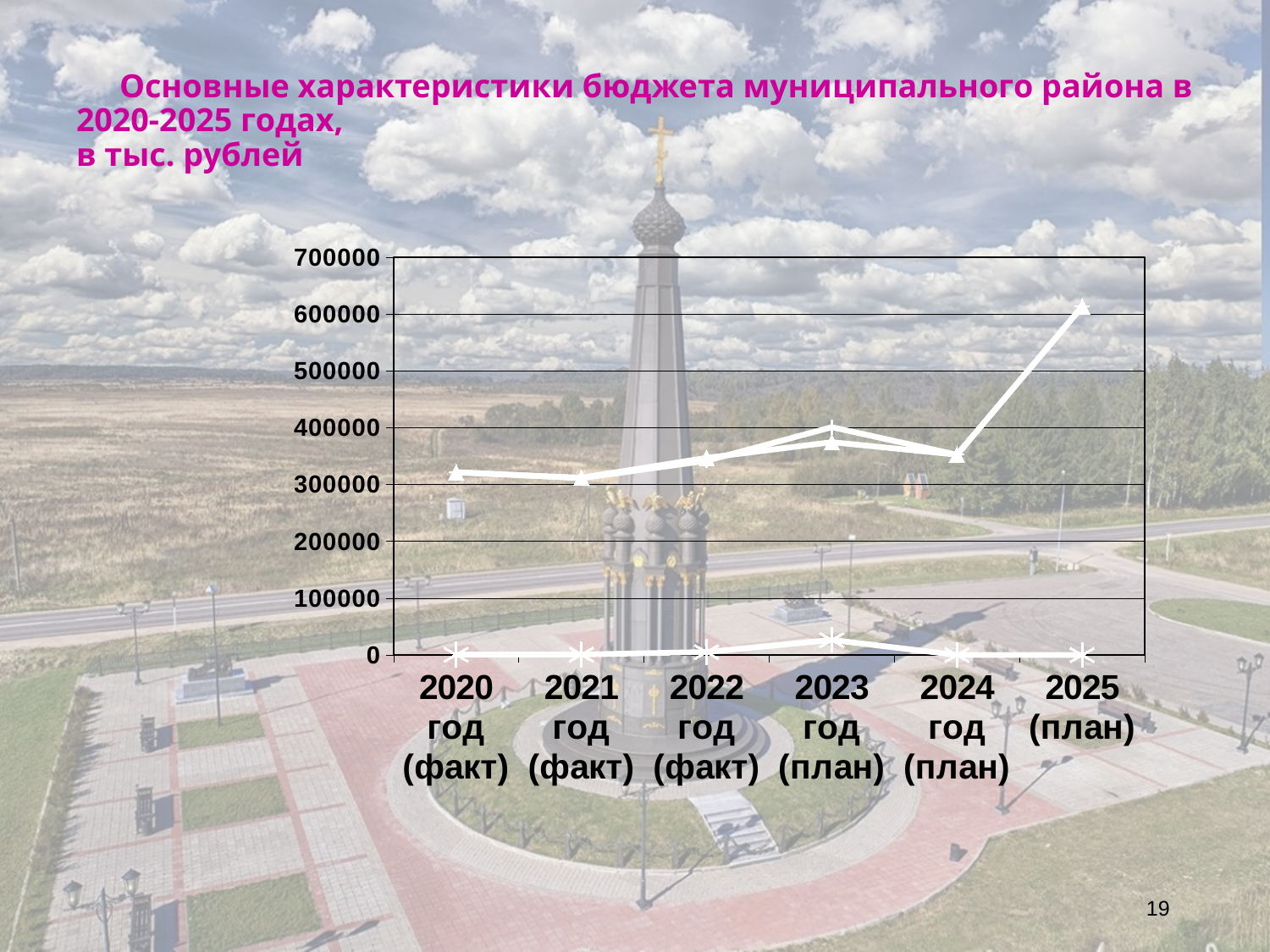
For the line with triangle markers, which is larger: the value for 2025 (план) or the value for 2020 год (факт)? 2025 (план) Does the line with triangle markers rise or fall between 2024 год (план) and 2025 (план)? rise What is the highest value shown on the vertical axis of the chart? 700000 Is the value of the line with triangle markers for 2022 год (факт) greater or less than 300000? greater Is the value of the line with star markers for 2023 год (план) greater or less than 100000? less In which year does the line with triangle markers reach its highest value? 2025 (план) How many years (categories) are shown on the x axis of the chart? 6 Is the value of the line with triangle markers for 2024 год (план) greater or less than 400000? less What kind of chart is shown on the slide? line chart What is the title of the chart on the slide? Основные характеристики бюджета муниципального района в 2020-2025 годах, в тыс. рублей